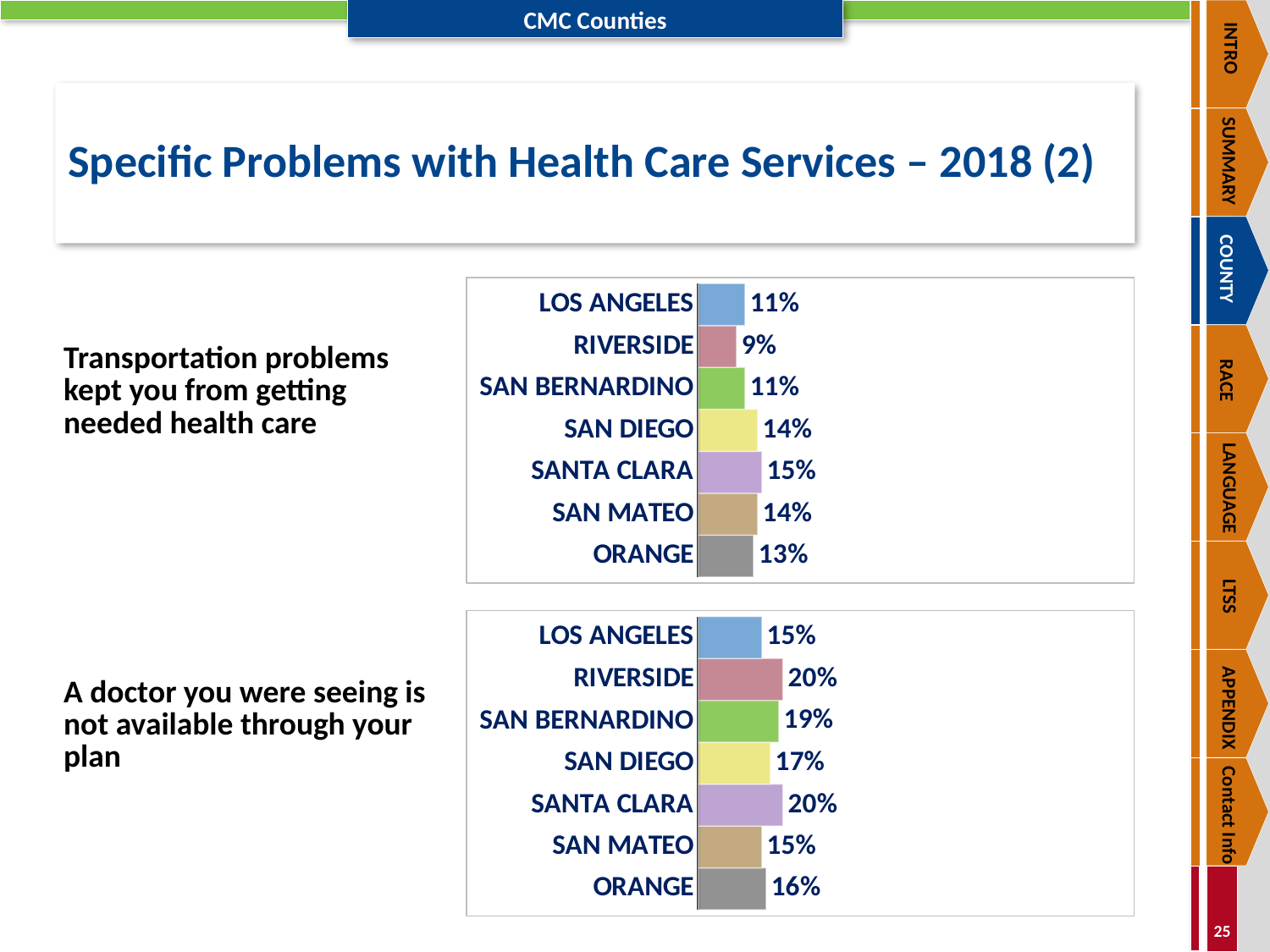
In the top chart (Transportation problems kept you from getting needed health care), which county has the lowest value? Riverside In the top chart (Transportation problems kept you from getting needed health care), what is the value for Riverside? 9% In the top chart (Transportation problems kept you from getting needed health care), what is the difference between Santa Clara and Riverside? 6% In the top chart (Transportation problems kept you from getting needed health care), which is larger, Los Angeles or Orange? Orange In the bottom chart (A doctor you were seeing is not available through your plan), what is the value for San Bernardino? 19% In the bottom chart (A doctor you were seeing is not available through your plan), which is larger, Riverside or San Diego? Riverside In the top chart (Transportation problems kept you from getting needed health care), which county has the highest value? Santa Clara How many counties are shown in the bottom chart (A doctor you were seeing is not available through your plan)? 7 In the bottom chart (A doctor you were seeing is not available through your plan), what is the value for Orange? 16% What type of chart is the top chart (Transportation problems kept you from getting needed health care)? Bar chart In the top chart (Transportation problems kept you from getting needed health care), what is the value for San Diego? 14% In the bottom chart (A doctor you were seeing is not available through your plan), what is the difference between Santa Clara and San Mateo? 5%